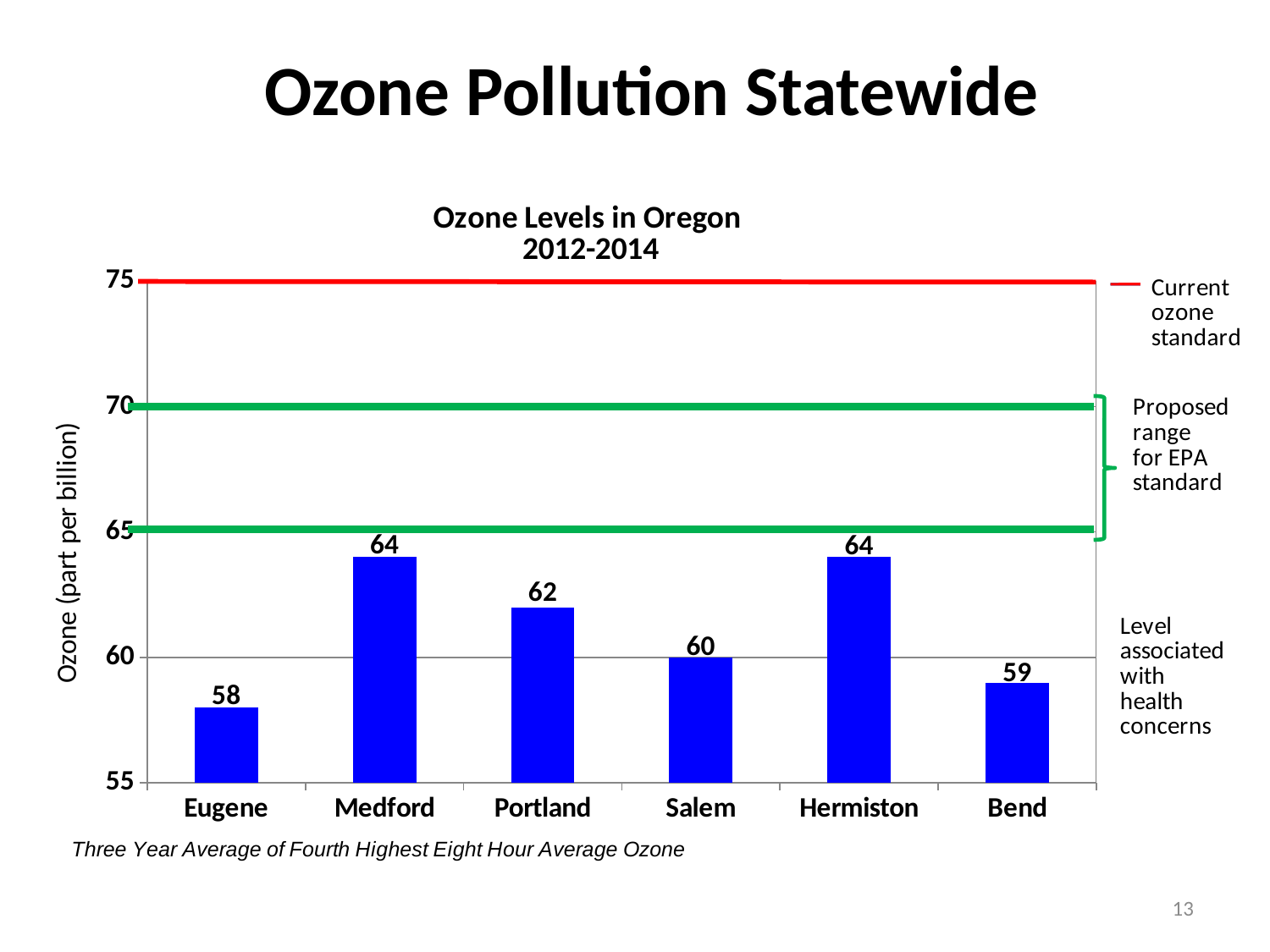
What is the ozone level for Portland? 62 How many cities are shown on the x axis? 6 What is the title of the chart? Ozone Levels in Oregon 2012-2014 Which is larger, the ozone level for Portland or for Bend? Portland Which city has the lowest ozone level? Eugene What kind of chart is this? bar chart What is the difference between the ozone levels for Medford and Salem? 4 What does the red line on the chart represent? Current ozone standard Is the value for Hermiston greater or less than 65? less What is the y-axis label? Ozone (part per billion) What is the ozone level for Eugene? 58 What is the ozone level for Bend? 59